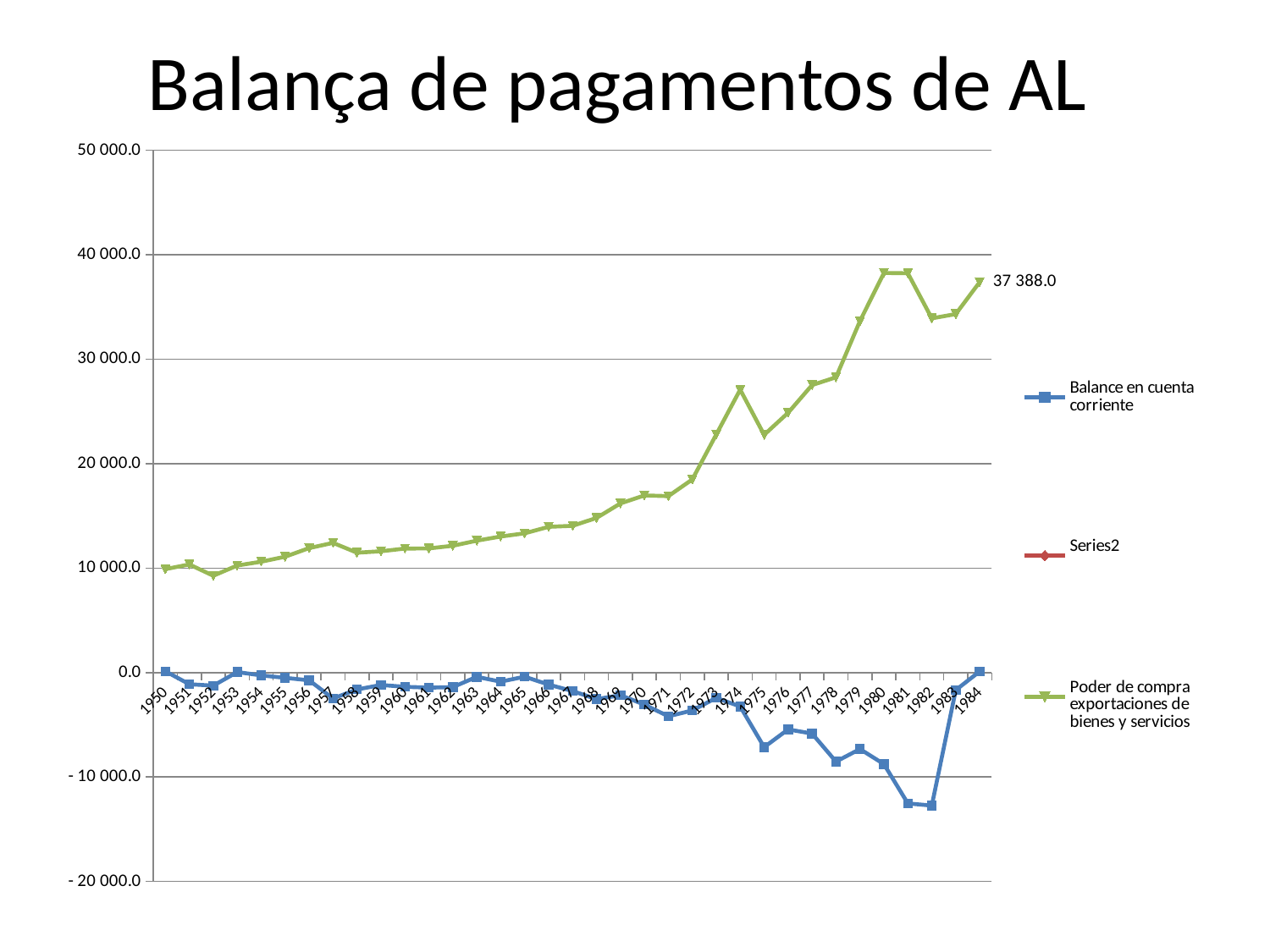
Is the value for 'Balance en cuenta corriente' in 1982 greater or less than -10 000.0? less Which year has the higher value for 'Poder de compra exportaciones de bienes y servicios', 1981 or 1982? 1981 What kind of chart is shown on the slide? line chart Which year has the higher value for 'Poder de compra exportaciones de bienes y servicios', 1974 or 1975? 1974 How many series does the legend list? 3 Is the value for 'Poder de compra exportaciones de bienes y servicios' in 1950 greater or less than 20 000.0? less What is the value of 'Poder de compra exportaciones de bienes y servicios' in 1984? 37 388.0 What is the title of the chart? Balança de pagamentos de AL Does the 'Poder de compra exportaciones de bienes y servicios' series generally rise or fall from 1950 to 1984? rise How many years are plotted along the x axis? 35 Is the value for 'Poder de compra exportaciones de bienes y servicios' in 1980 greater or less than 30 000.0? greater